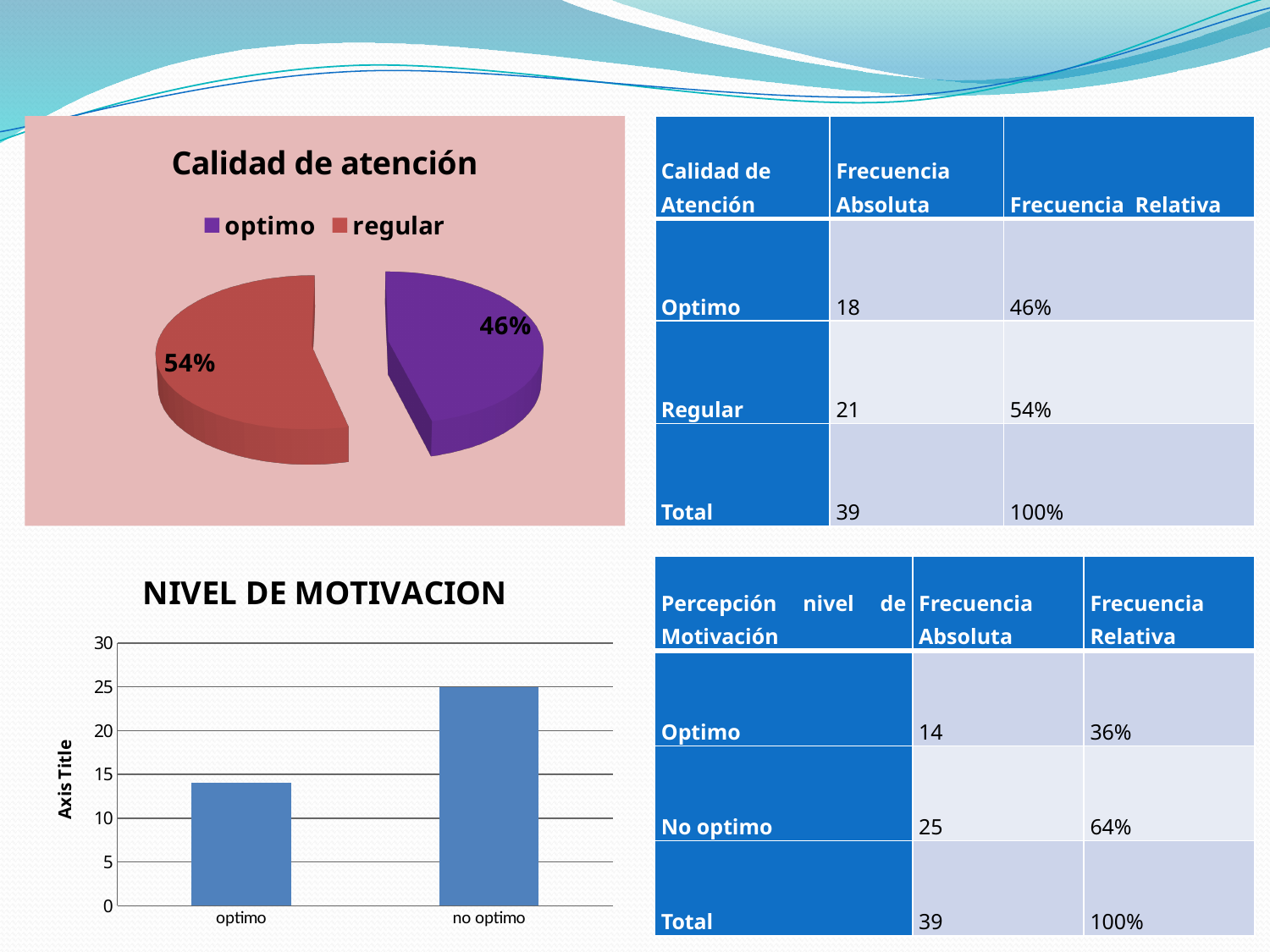
In the 'NIVEL DE MOTIVACION' chart, how many categories are shown on the x axis? 2 In the 'Calidad de atención' chart, what share of the pie does 'optimo' take? 46% In the 'Calidad de atención' chart, which slice is the largest? regular In the 'Calidad de atención' chart, what share of the pie does 'regular' take? 54% In the 'NIVEL DE MOTIVACION' chart, which category has the highest value? no optimo What kind of chart is 'Calidad de atención'? pie chart What kind of chart is 'NIVEL DE MOTIVACION'? bar chart In the 'NIVEL DE MOTIVACION' chart, what is the label on the vertical axis? Axis Title In the 'Calidad de atención' chart, how many entries does the legend list? 2 In the 'NIVEL DE MOTIVACION' chart, what is the value for 'no optimo'? 25 In the 'NIVEL DE MOTIVACION' chart, is the value for 'optimo' greater or less than 15? less In the 'Calidad de atención' chart, what is the difference in percentage points between 'regular' and 'optimo'? 8%